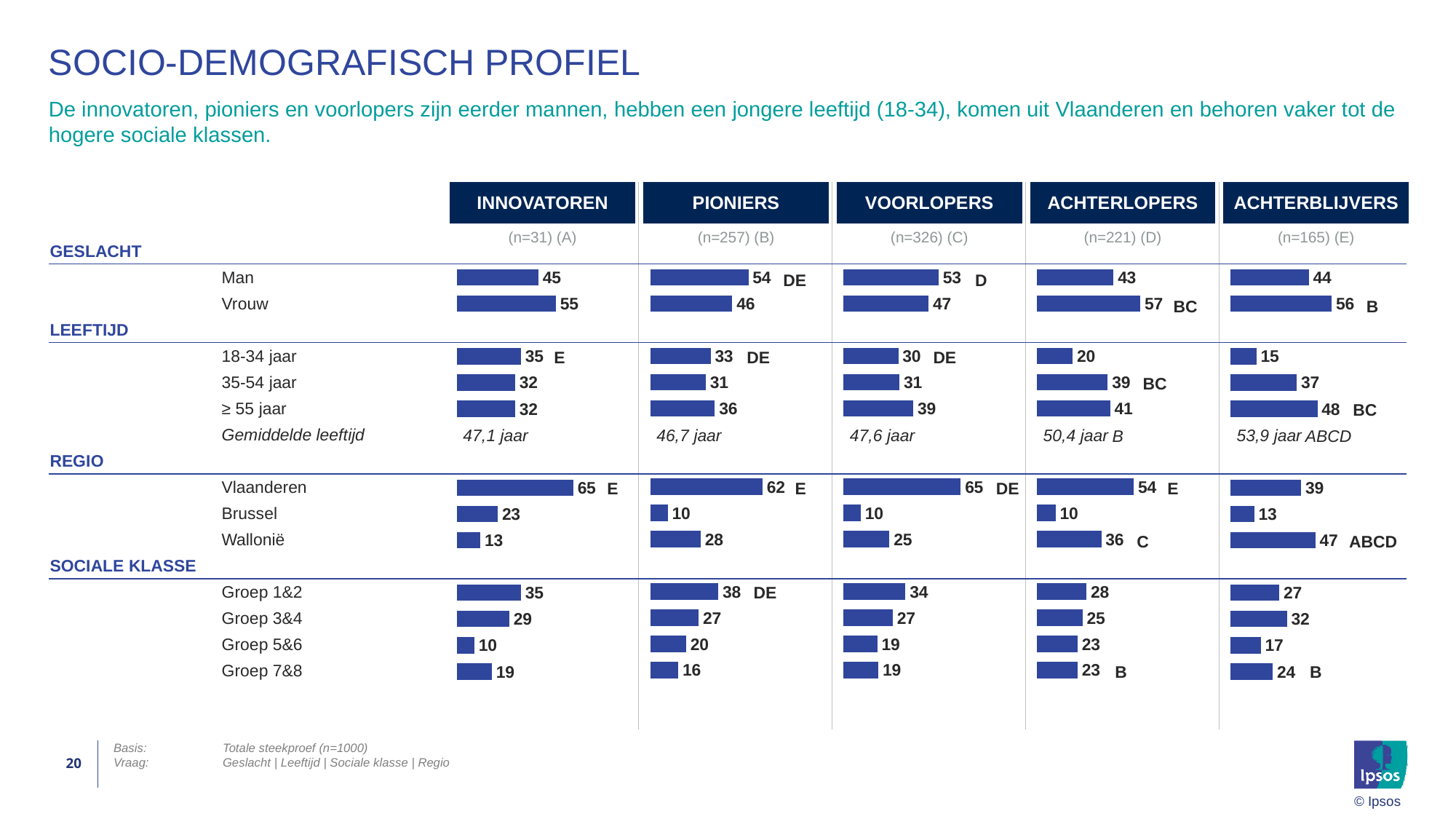
What is the difference between the Vlaanderen value for INNOVATOREN and the Vlaanderen value for ACHTERBLIJVERS? 26 In the ACHTERBLIJVERS column, what is the value for Wallonië? 47 What is the Gemiddelde leeftijd shown for ACHTERBLIJVERS? 53,9 jaar What kind of chart is used to display the values in the table? bar chart In the INNOVATOREN column, what is the value for Man? 45 Which is larger: the 18-34 jaar value for INNOVATOREN or the 18-34 jaar value for ACHTERBLIJVERS? INNOVATOREN In the REGIO section of the PIONIERS column, which region has the highest value? Vlaanderen In the VOORLOPERS column, what is the value for Vlaanderen? 65 In the ACHTERBLIJVERS column, do the values rise or fall going from 18-34 jaar to ≥ 55 jaar? rise In the ACHTERLOPERS column, what is the difference between the values for Vrouw and Man? 14 How many segment columns (INNOVATOREN through ACHTERBLIJVERS) are shown on the slide? 5 In the SOCIALE KLASSE section of the INNOVATOREN column, which group has the lowest value? Groep 5&6